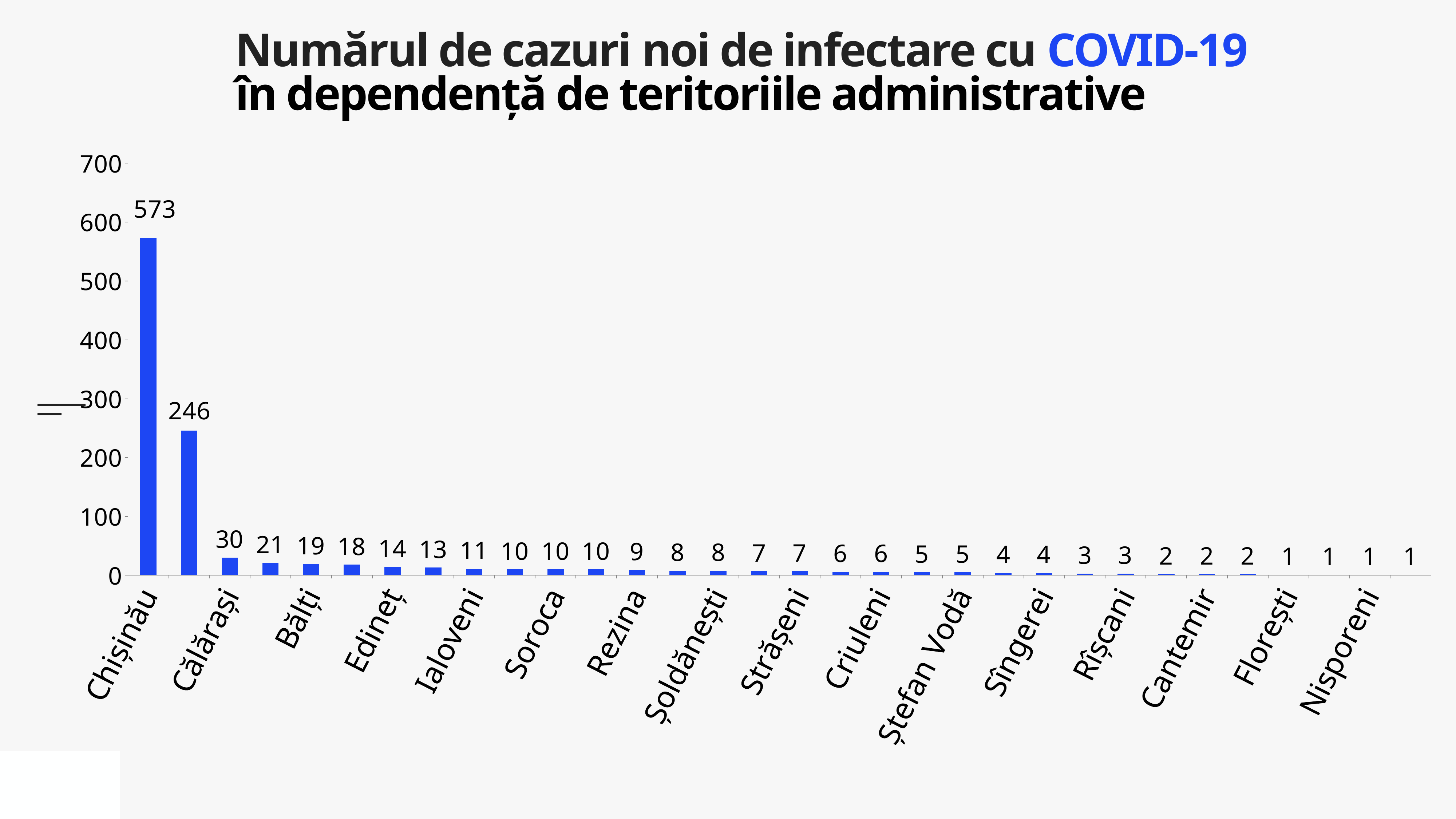
What is the number of new cases for Cantemir? 2 Do the values rise or fall from left to right along the x axis? fall What type of chart is shown on the slide? bar chart How many bars are plotted in the chart? 32 Which has more new cases, Chișinău or Florești? Chișinău What is the difference between the values for Chișinău and Soroca? 563 What is the number of new COVID-19 cases for Chișinău? 573 What is the lowest value shown on any bar in the chart? 1 What is the number of new cases for Soroca? 10 Which territory has the highest number of new cases? Chișinău Is the value for Chișinău greater or less than 500? greater What is the number of new cases for Nisporeni? 1